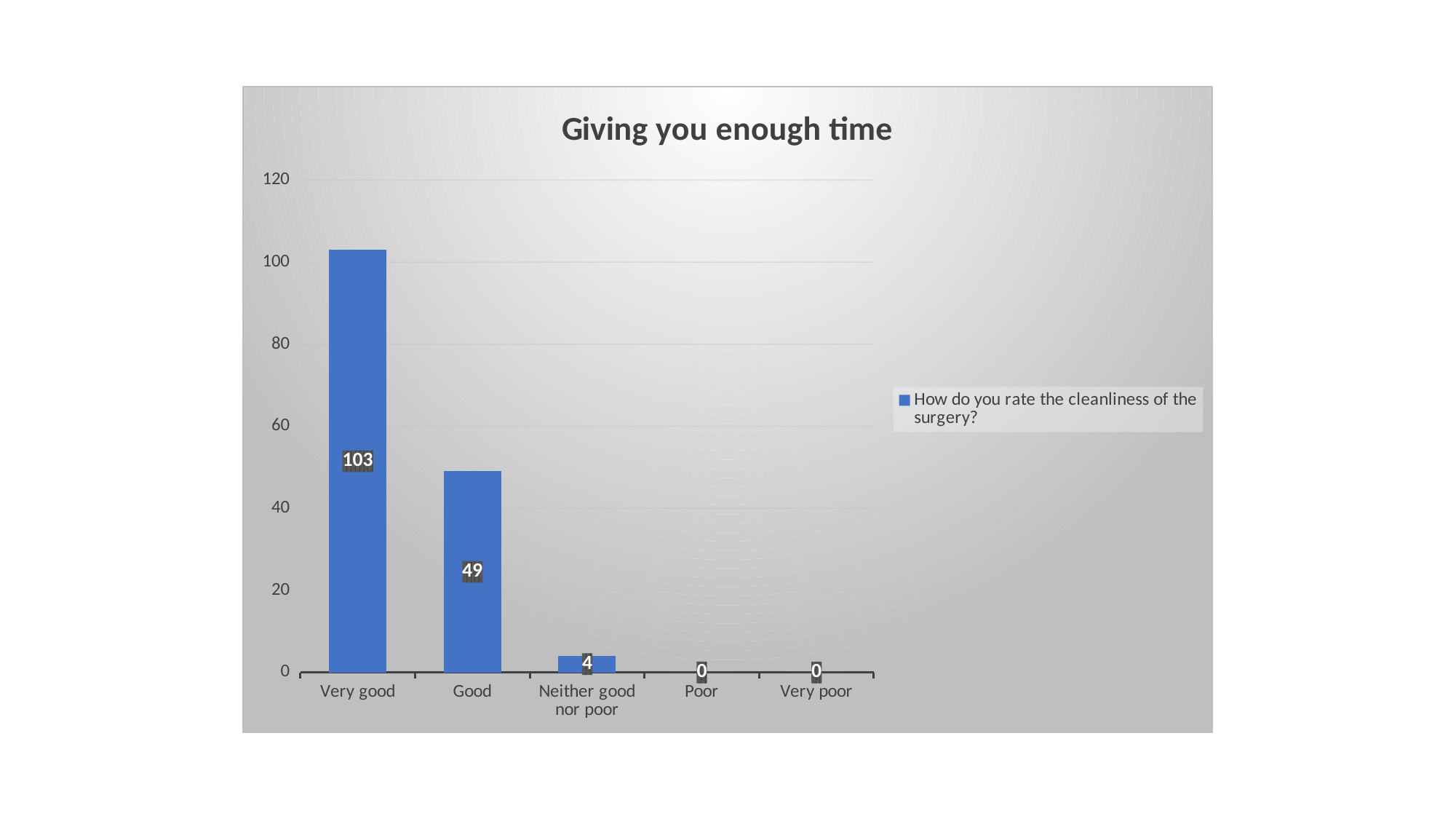
What is the difference between the values for Very good and Good? 54 What is the value for Good? 49 How many categories are shown on the x axis? 5 Which is larger, the value for Good or the value for Neither good nor poor? Good What is the title of the chart? Giving you enough time What is the value for Neither good nor poor? 4 Which category has the highest value? Very good Is the value for Very good greater or less than 100? greater What kind of chart is shown? bar chart How many series does the legend list? 1 What is the value for Very good? 103 What is the value for Poor? 0